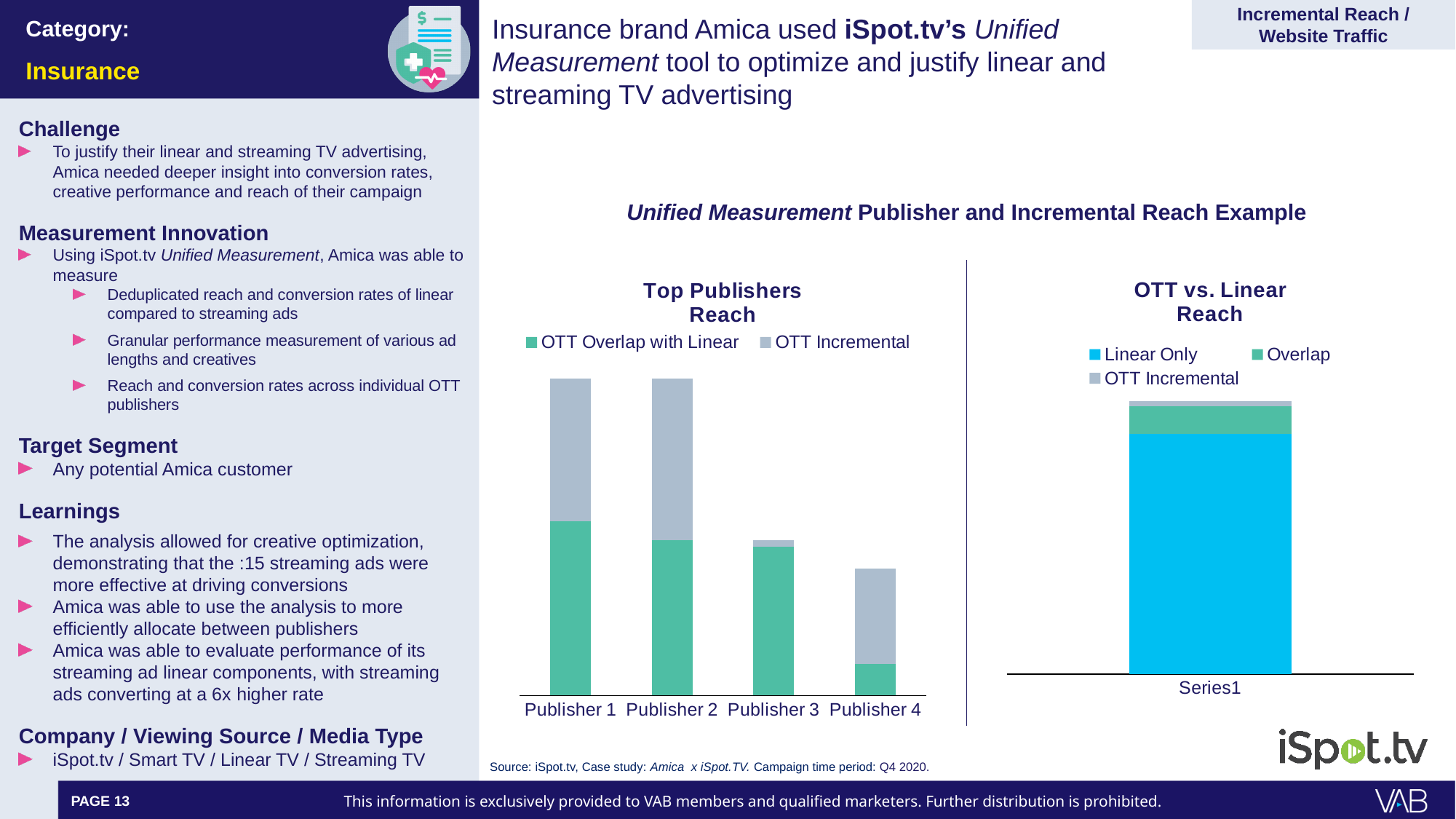
How many publishers are shown on the x axis of the 'Top Publishers Reach' chart? 4 In the 'Top Publishers Reach' chart, which publisher has the largest OTT Overlap with Linear segment? Publisher 1 In the 'Top Publishers Reach' chart, is the OTT Incremental segment larger for Publisher 2 or Publisher 3? Publisher 2 In the 'OTT vs. Linear Reach' chart, which series makes up the smallest segment of the bar? OTT Incremental In the 'OTT vs. Linear Reach' chart, which series makes up the largest segment of the bar? Linear Only What type of chart is the 'Top Publishers Reach' chart? Stacked bar chart In the 'Top Publishers Reach' chart, which publisher has the lowest total bar? Publisher 4 How many series does the legend of the 'OTT vs. Linear Reach' chart list? 3 How many series does the legend of the 'Top Publishers Reach' chart list? 2 In the 'Top Publishers Reach' chart, which publisher has the smallest OTT Incremental segment? Publisher 3 In the 'Top Publishers Reach' chart, is the total bar for Publisher 1 or Publisher 4 taller? Publisher 1 What colour represents 'Linear Only' in the 'OTT vs. Linear Reach' chart? Blue